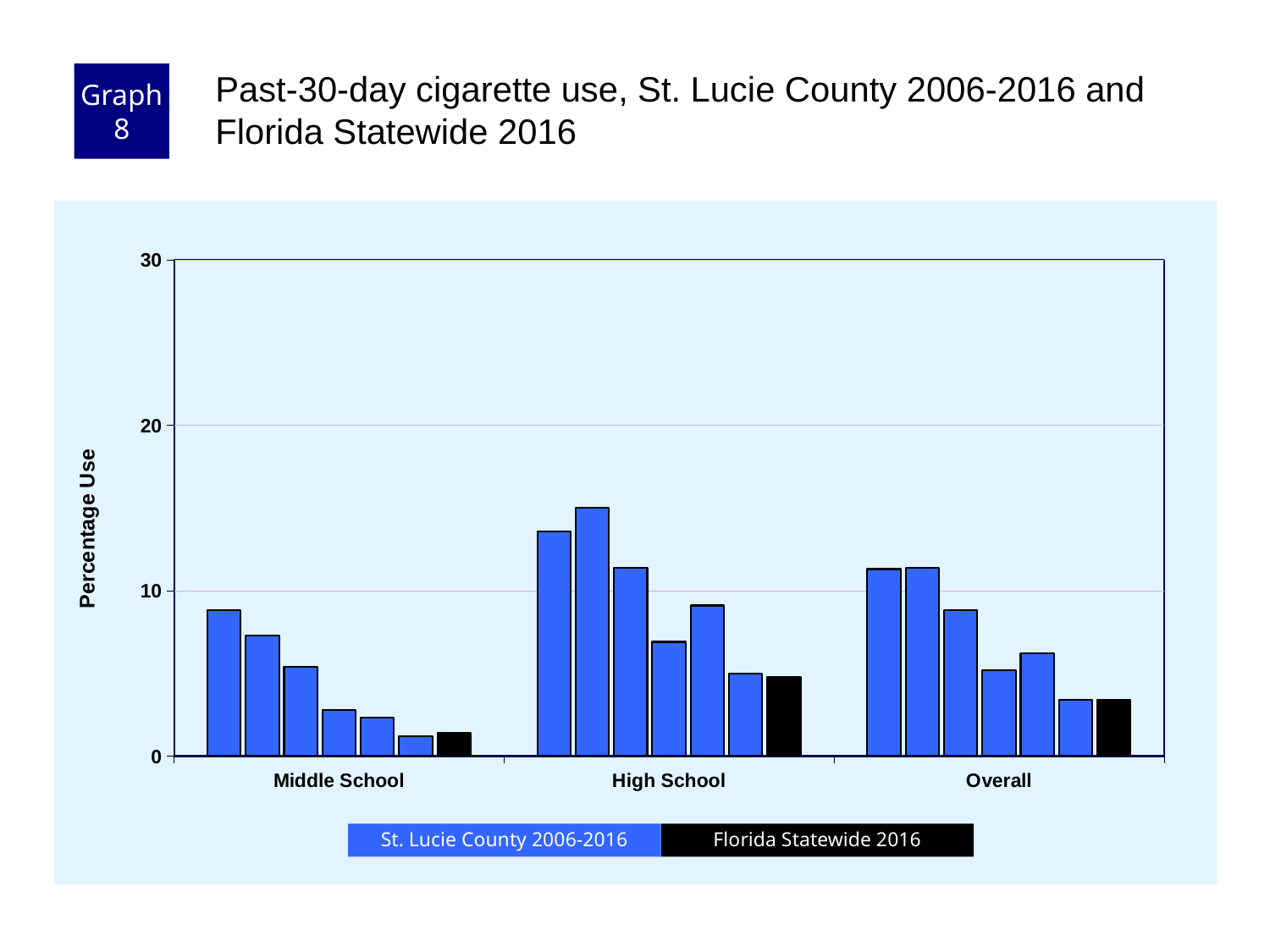
Is the first (leftmost) St. Lucie County bar in the Overall group greater or less than 10? greater Is the Florida Statewide 2016 value for High School greater or less than 10? less Which is larger, the Florida Statewide 2016 value for High School or for Middle School? High School Do the St. Lucie County bars in the Middle School group rise or fall from left to right? fall Which category contains the tallest bar in the chart? High School What kind of chart is shown on the slide? bar chart What is the label on the y axis? Percentage Use Is the tallest St. Lucie County bar in the Middle School group greater or less than 10? less What colour are the Florida Statewide 2016 bars? black How many categories are shown along the x axis? 3 How many series does the legend list? 2